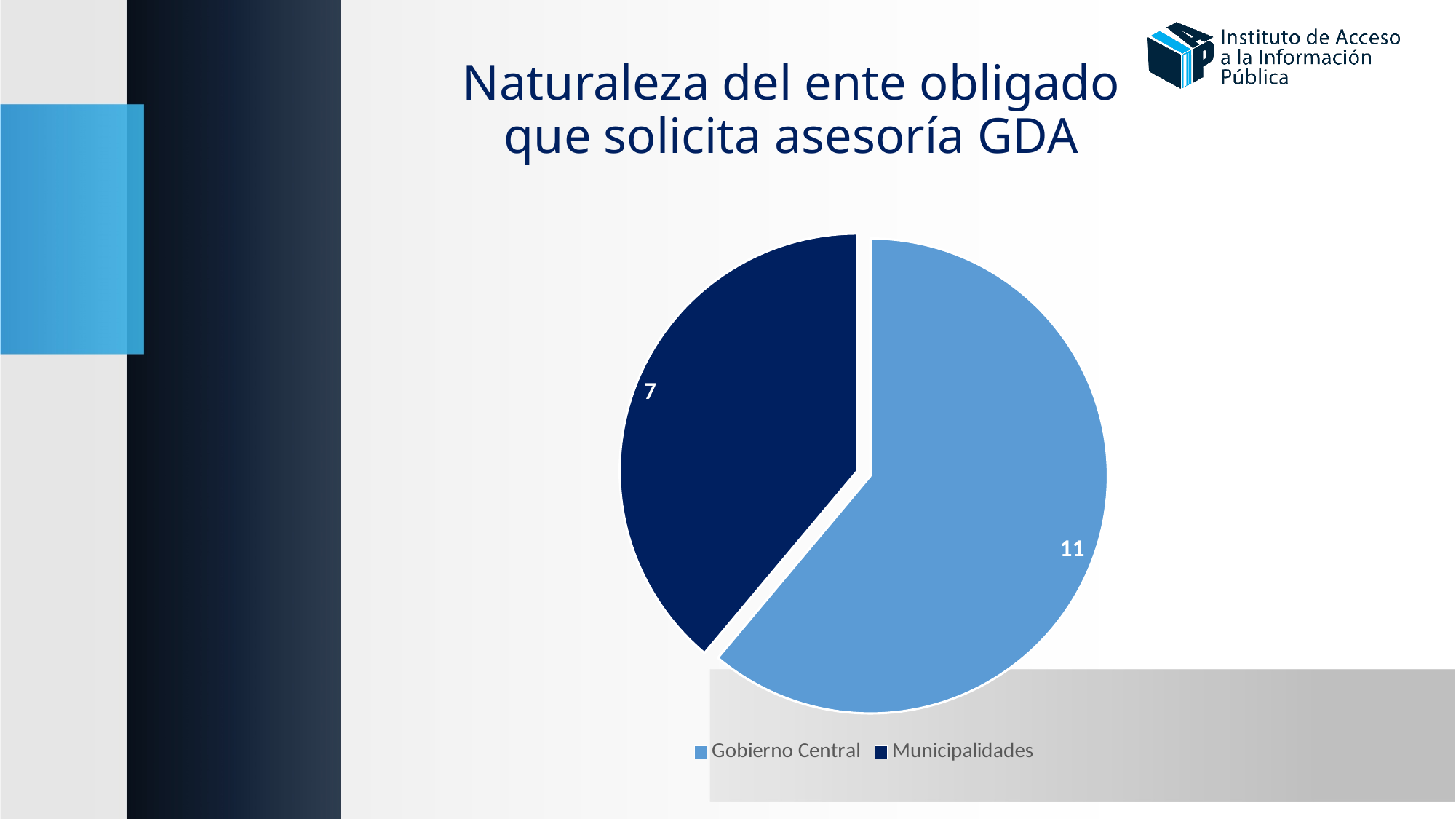
What is the difference between the values for Gobierno Central and Municipalidades? 4 Which category has the largest slice of the pie? Gobierno Central What is the value for Municipalidades? 7 Which category has the smallest slice of the pie? Municipalidades What kind of chart is shown on the slide? Pie chart Which category is shown in dark blue in the legend? Municipalidades What is the title of the chart? Naturaleza del ente obligado que solicita asesoría GDA What is the value for Gobierno Central? 11 How many categories does the pie chart show? 2 What is the total of the two slices in the pie chart? 18 Which is larger, the value for Gobierno Central or the value for Municipalidades? Gobierno Central